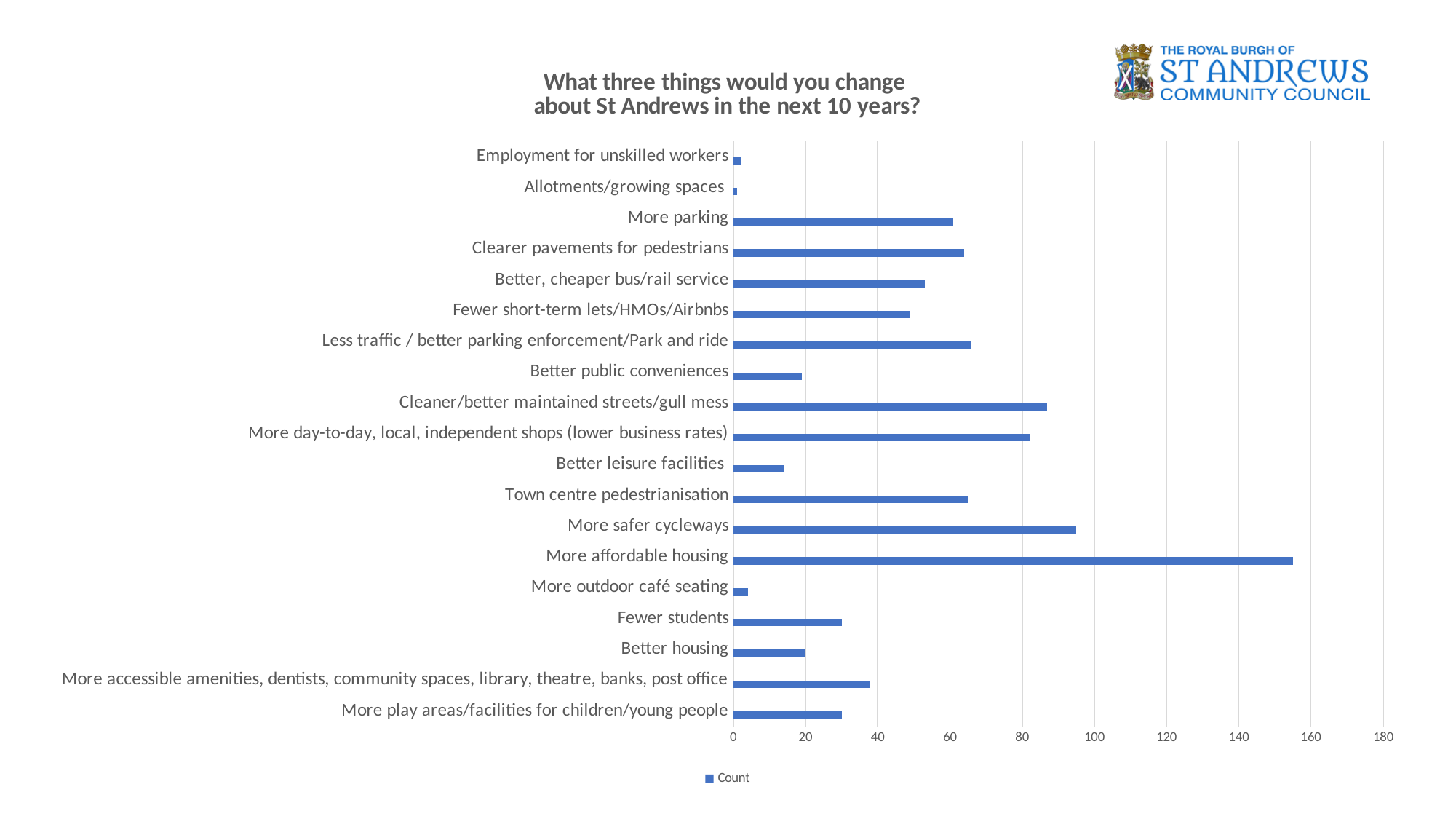
What kind of chart is shown on the slide? Bar chart Is the value for More affordable housing greater or less than 140? greater Which has the larger count, Fewer students or More accessible amenities, dentists, community spaces, library, theatre, banks, post office? More accessible amenities, dentists, community spaces, library, theatre, banks, post office How many categories are plotted on the chart? 19 Is the value for More safer cycleways greater or less than 80? greater Which has the larger count, More safer cycleways or Cleaner/better maintained streets/gull mess? More safer cycleways Is the value for Better public conveniences greater or less than 40? less Which category has the highest count? More affordable housing How many series does the legend list? 1 What is the title of the chart? What three things would you change about St Andrews in the next 10 years?